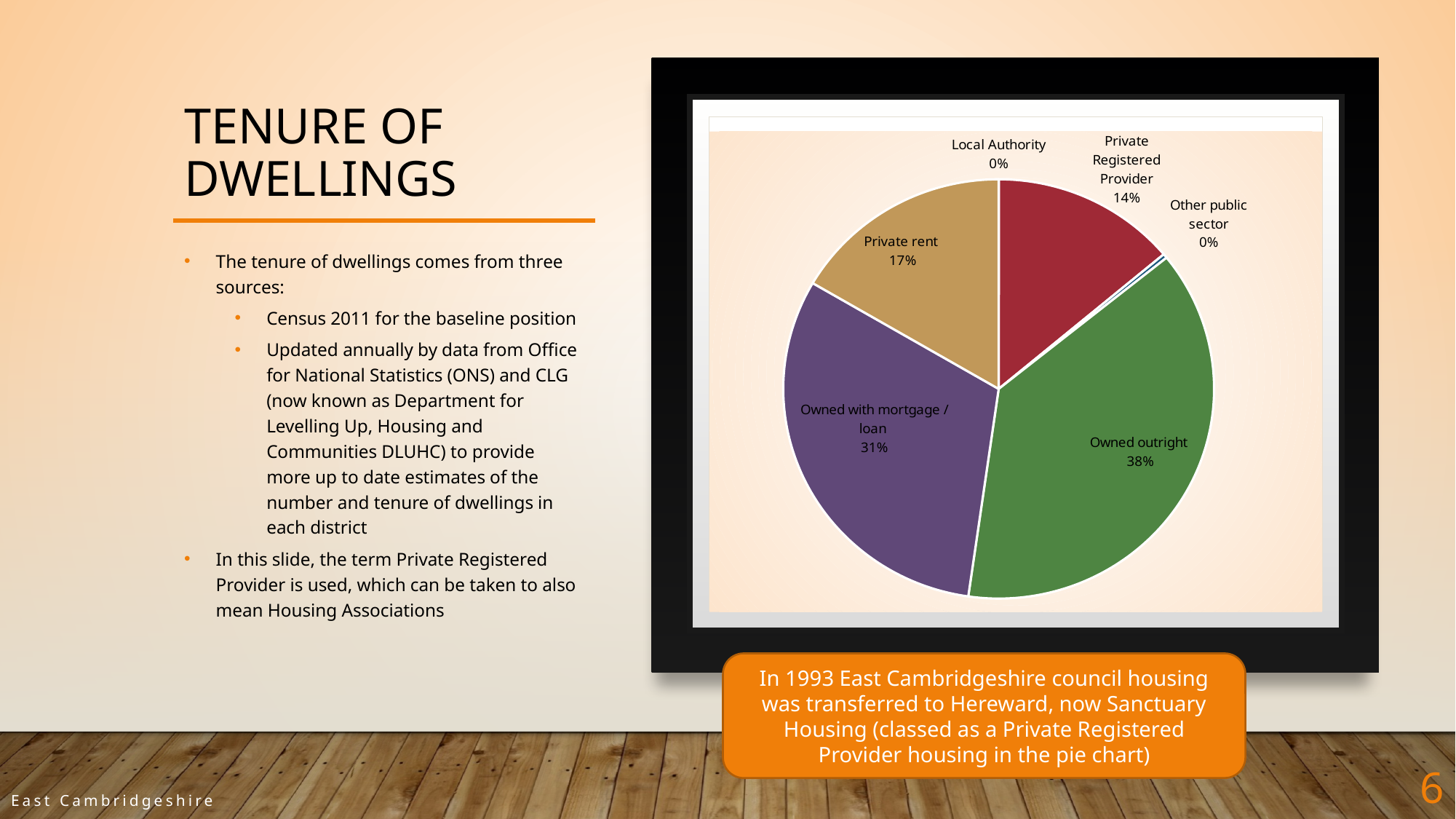
What kind of chart is shown on the slide? pie chart What is the combined share of Owned outright and Owned with mortgage / loan? 69% What colour is the Owned outright slice? green What share of dwellings is Private rent? 17% What share of dwellings is Owned outright? 38% Which tenure category has the largest share of the pie? Owned outright What is the difference in percentage points between Owned outright and Owned with mortgage / loan? 7 What share of dwellings is Owned with mortgage / loan? 31% What share of dwellings is Private Registered Provider? 14% How many tenure categories are labelled on the pie chart? 6 Which is larger, Private rent or Private Registered Provider? Private rent What share of dwellings is Local Authority? 0%